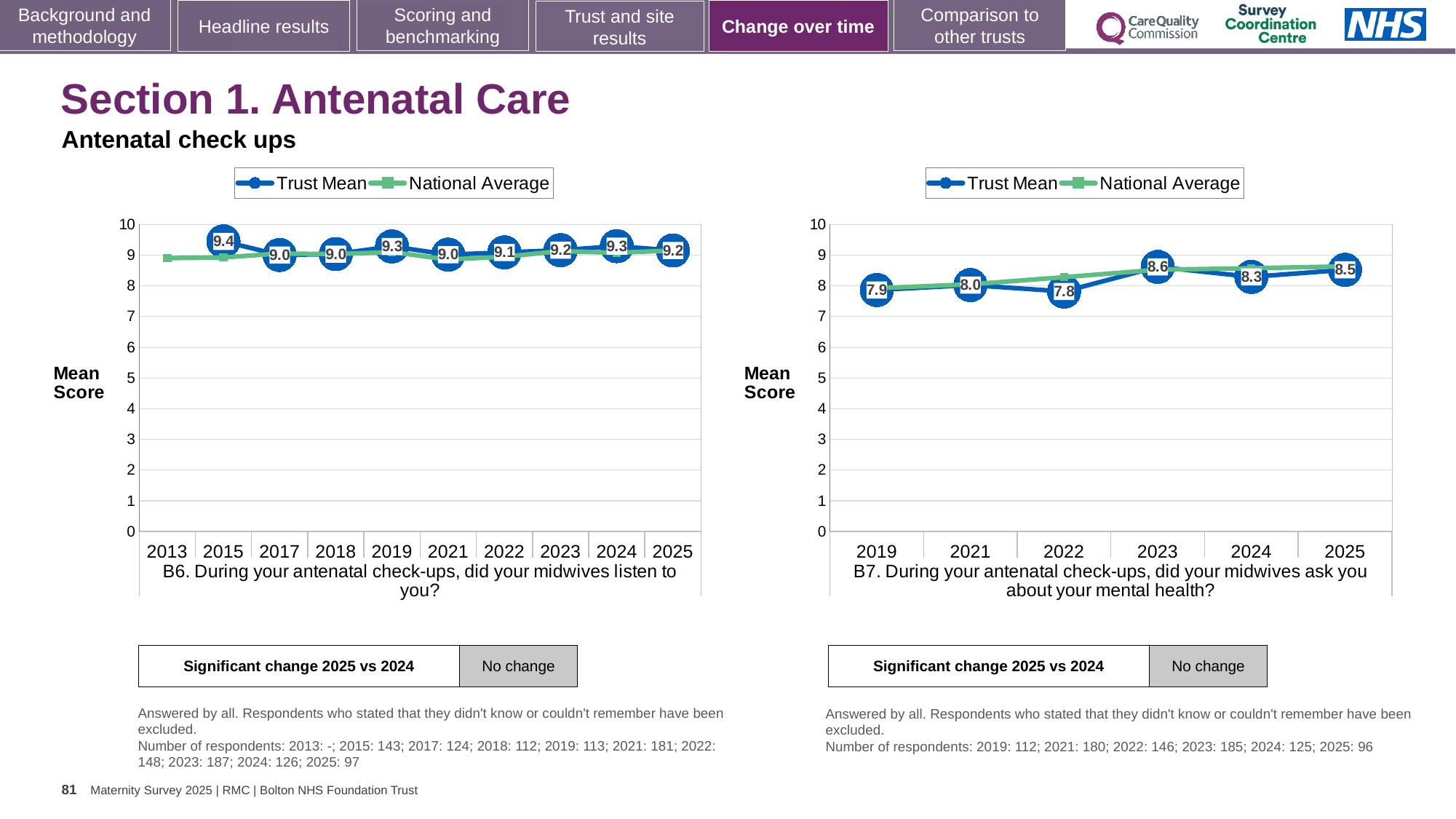
In the B7 chart (right), which year has the highest Trust Mean score? 2023 In the B7 chart (right), what is the Trust Mean score for 2022? 7.8 What kind of chart is the B7 chart (right)? Line chart In the B7 chart (right), what is the difference between the Trust Mean scores for 2023 and 2022? 0.8 In the B7 chart (right), is the Trust Mean score higher in 2025 or in 2024? 2025 In the B7 chart (right), which year has the lowest Trust Mean score? 2022 In the B6 chart (left), which year has the highest Trust Mean score? 2015 How many series does the legend of the B6 chart (left) list? 2 In the B6 chart (left), is the Trust Mean score for 2019 greater or less than 9? greater How many years are shown on the x axis of the B7 chart (right)? 6 In the B6 chart (left), what is the Trust Mean score for 2025? 9.2 In the B6 chart (left), what is the Trust Mean score for 2015? 9.4